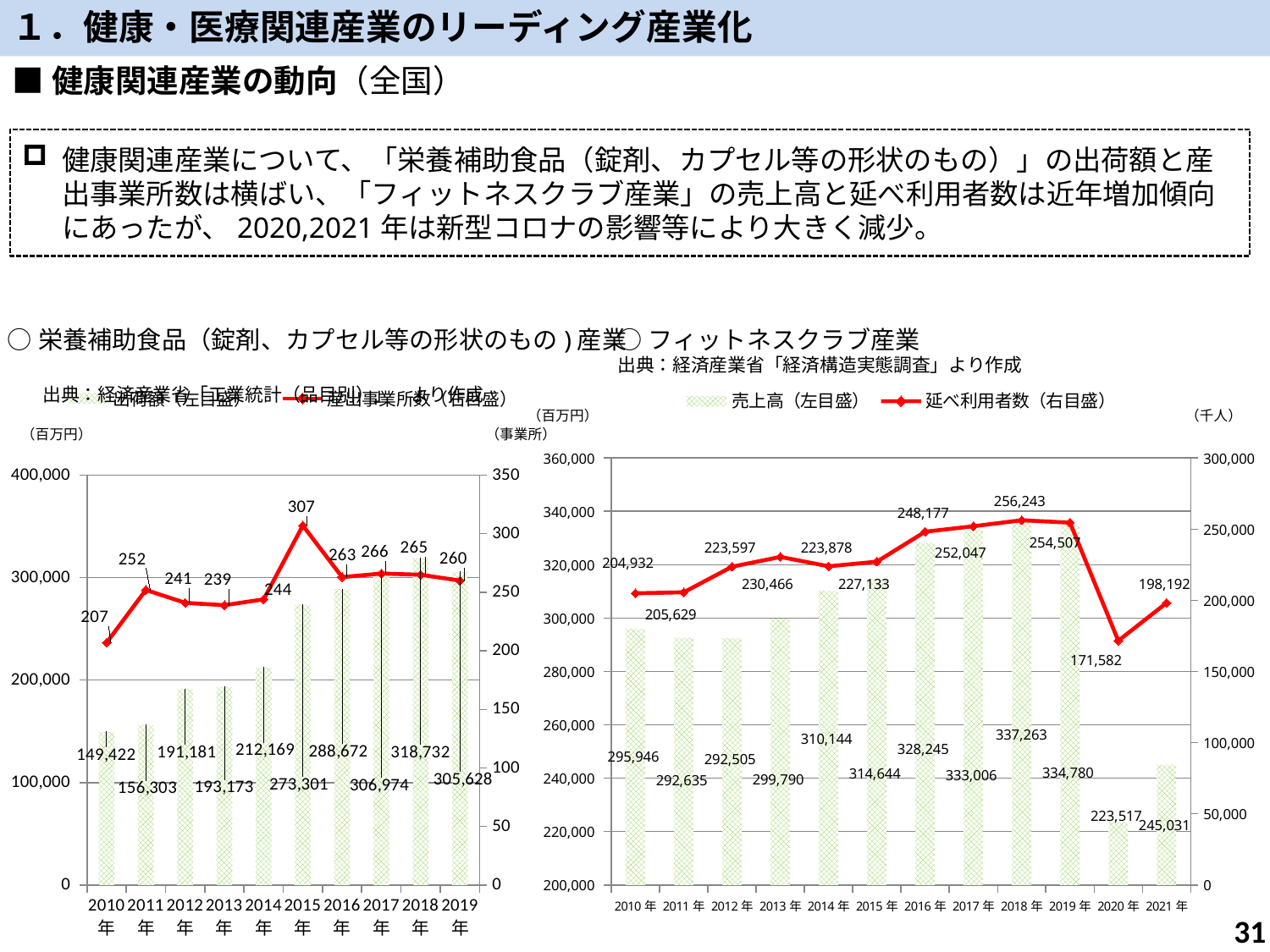
In the right chart (フィットネスクラブ産業), what is the 売上高 value for 2020年? 223,517 In the left chart (栄養補助食品 industry), which year has the lowest 出荷額? 2010年 In the right chart (フィットネスクラブ産業), which year has the lowest 延べ利用者数? 2020年 How many series does the legend of the right chart (フィットネスクラブ産業) list? 2 In the left chart (栄養補助食品 industry), what is the 出荷額 value for 2018年? 318,732 In the right chart (フィットネスクラブ産業), which year has the highest 売上高? 2018年 In the left chart (栄養補助食品 industry), what is the 産出事業所数 value for 2015年? 307 In the left chart (栄養補助食品 industry), how many years are shown on the x axis? 10 In the right chart (フィットネスクラブ産業), what is the difference in 売上高 between 2019年 and 2020年? 111,263 In the right chart (フィットネスクラブ産業), is the 延べ利用者数 for 2021年 larger or smaller than for 2020年? larger In the right chart (フィットネスクラブ産業), what is the 延べ利用者数 value for 2018年? 256,243 In the left chart (栄養補助食品 industry), what is the difference in 産出事業所数 between 2015年 and 2010年? 100